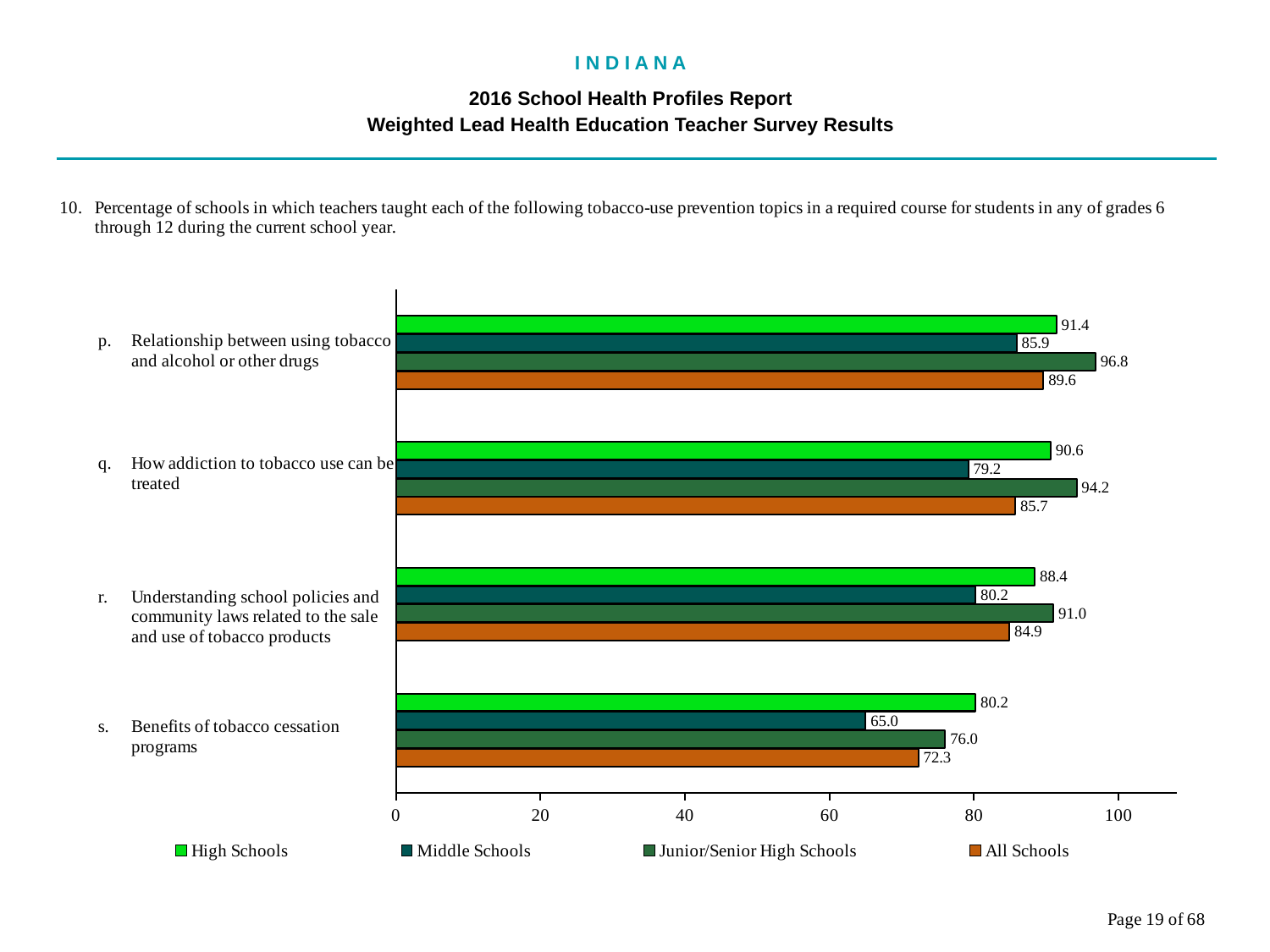
What is the value for All Schools for topic q, how addiction to tobacco use can be treated? 85.7 What kind of chart is shown on the slide? bar chart For topic s, which is larger: the High Schools value or the All Schools value? High Schools Which topic has the lowest value for Middle Schools? s. Benefits of tobacco cessation programs What is the value for High Schools for topic p, relationship between using tobacco and alcohol or other drugs? 91.4 How many series does the legend list? 4 Which topic has the highest value for Junior/Senior High Schools? p. Relationship between using tobacco and alcohol or other drugs What is the value for Junior/Senior High Schools for topic r, understanding school policies and community laws related to the sale and use of tobacco products? 91.0 What is the value for Middle Schools for topic s, benefits of tobacco cessation programs? 65.0 Is the Middle Schools value for topic q greater or less than 80? less What is the difference between the Junior/Senior High Schools and Middle Schools values for topic p? 10.9 How many topics are shown on the chart? 4